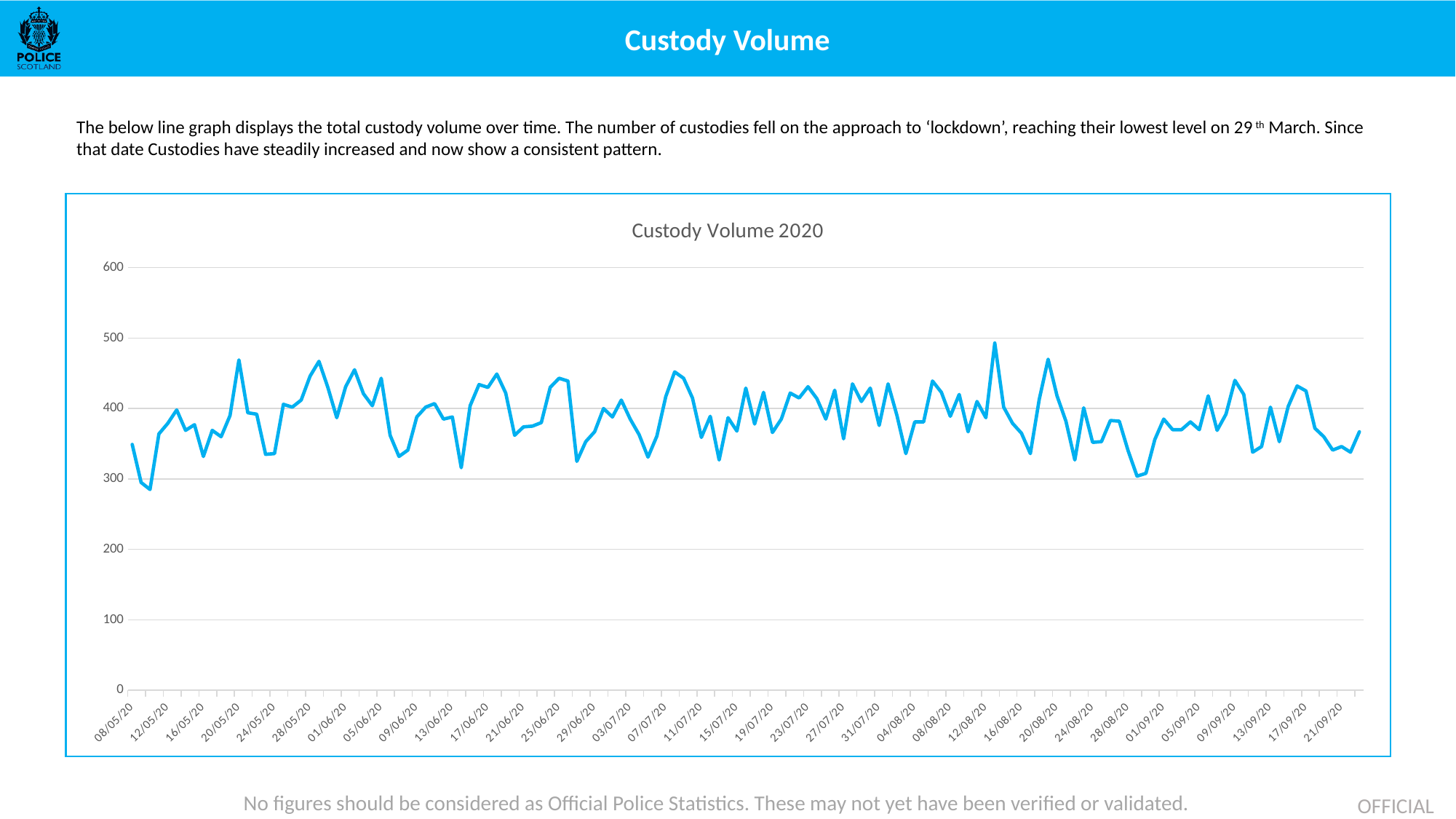
Is the highest value on the line greater or less than 400? greater What is the title of the chart? Custody Volume 2020 Is the value for 12/05/20 greater or less than 300? greater What kind of chart is shown on the slide? line chart Which of the two is larger: the value for 12/05/20 or the value for 20/05/20? 20/05/20 What is the first date label on the x axis? 08/05/20 Is the value for 20/05/20 greater or less than 400? greater What is the highest value shown on the y axis of the chart? 600